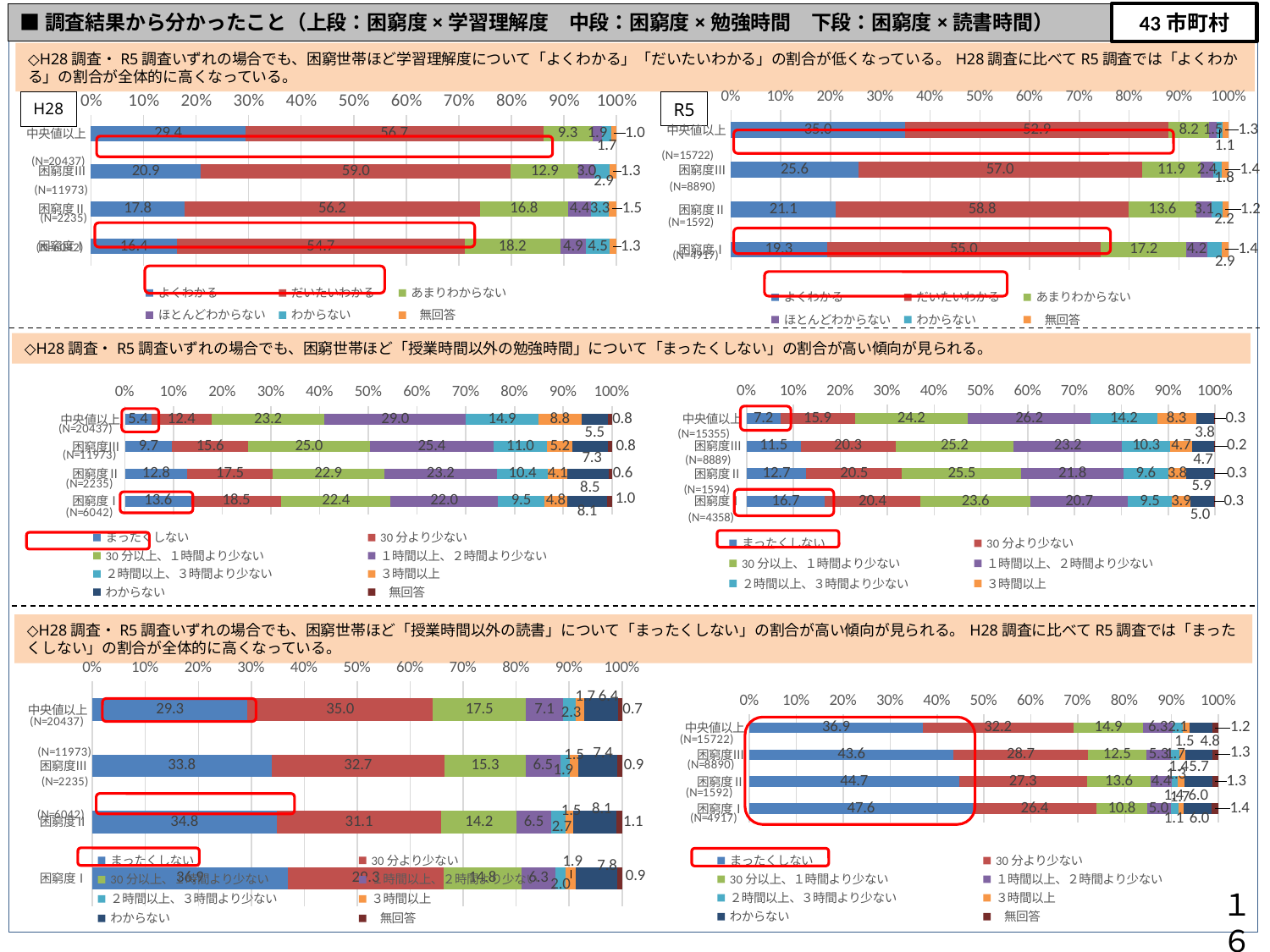
In the top-right R5 chart (困窮度×学習理解度), which category has the highest value for 「よくわかる」? 中央値以上 In the bottom-right R5 chart (困窮度×読書時間), what is the value of 「まったくしない」 for 困窮度I? 47.6 What kind of chart is the top-left H28 chart (困窮度×学習理解度)? Stacked horizontal bar chart In the top-right R5 chart (困窮度×学習理解度), what is the value of 「だいたいわかる」 for 困窮度II? 58.8 In the bottom-right R5 chart (困窮度×読書時間), how does the 「まったくしない」 value change going from 中央値以上 down to 困窮度I? It rises In the top-left H28 chart (困窮度×学習理解度), what is the value of 「よくわかる」 for 中央値以上? 29.4 In the middle-right R5 chart (困窮度×勉強時間), which category has the lowest value for 「まったくしない」? 中央値以上 In the middle-right R5 chart (困窮度×勉強時間), which is larger: the 「まったくしない」 value for 困窮度I or for 困窮度III? 困窮度I In the bottom-left H28 chart (困窮度×読書時間), what is the value of 「30分より少ない」 for 中央値以上? 35.0 How many series does the legend of the middle-left H28 chart (困窮度×勉強時間) list? 8 In the middle-left H28 chart (困窮度×勉強時間), what is the value of 「まったくしない」 for 困窮度I? 13.6 In the top-left H28 chart (困窮度×学習理解度), what is the difference between the 「よくわかる」 values for 中央値以上 and 困窮度I? 13.0